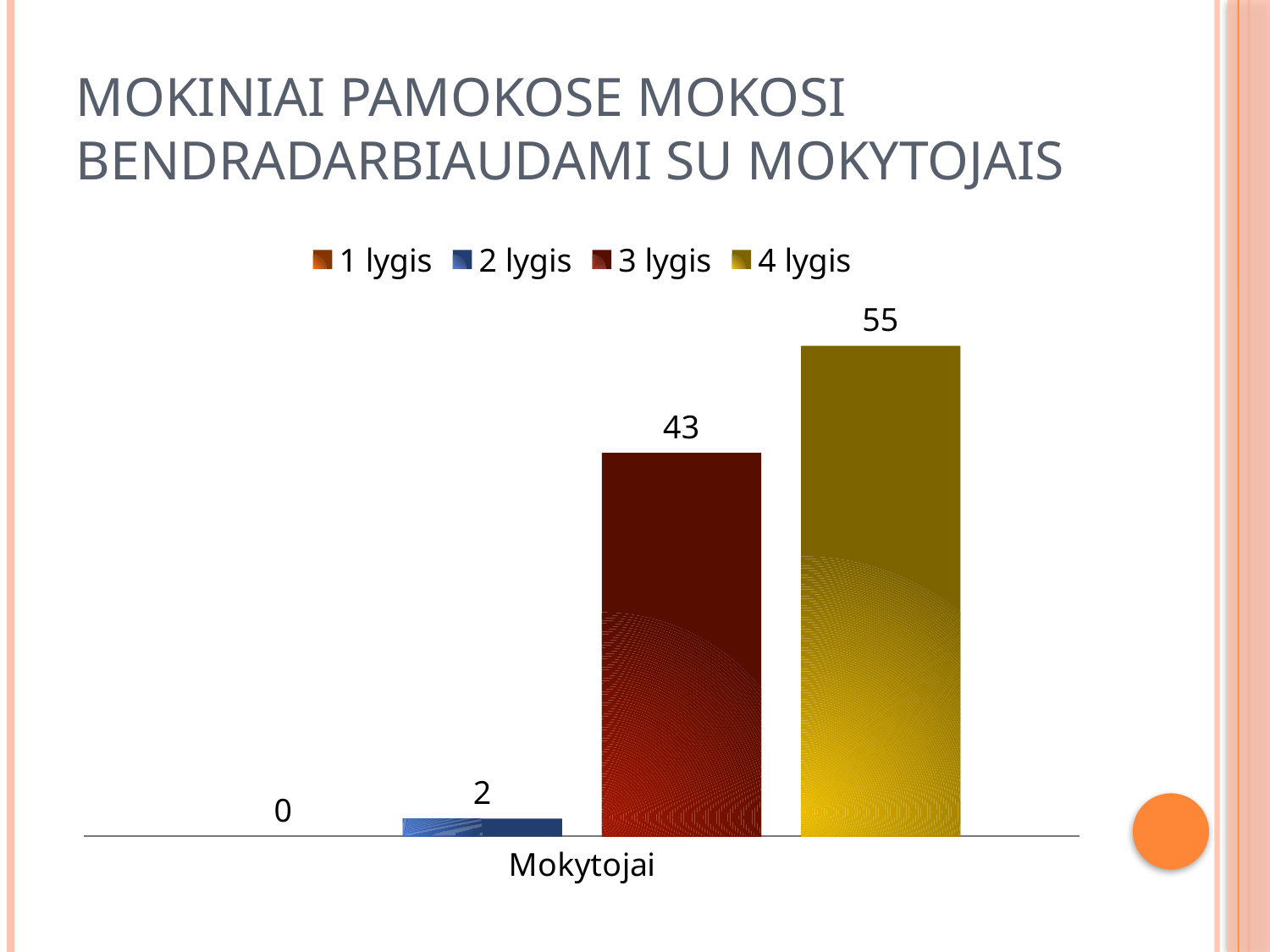
Which is larger, the value for 3 lygis or the value for 2 lygis? 3 lygis What is the difference between the values for 3 lygis and 2 lygis? 41 What kind of chart is shown on the slide? bar chart What is the category label shown on the x axis? Mokytojai What is the value for 1 lygis in the Mokytojai category? 0 What is the value for 3 lygis in the Mokytojai category? 43 What is the difference between the values for 4 lygis and 3 lygis? 12 Which series has the highest value? 4 lygis What is the value for 4 lygis in the Mokytojai category? 55 Which series has the lowest value? 1 lygis How many series does the legend list? 4 What is the value for 2 lygis in the Mokytojai category? 2